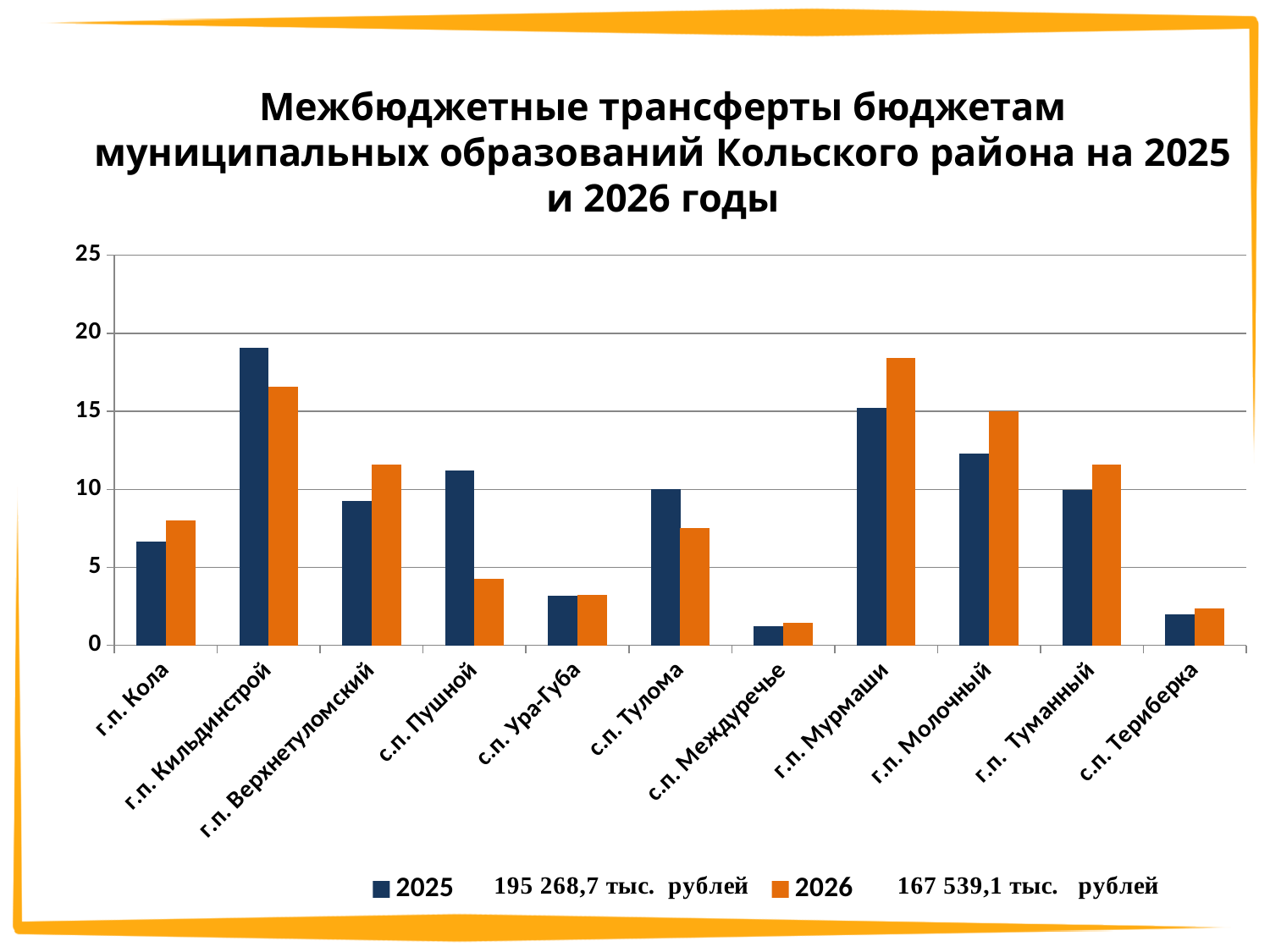
Is the 2025 value for г.п. Кильдинстрой greater or less than 15? greater What kind of chart is shown on the slide? bar chart What colour are the bars for the 2026 series? orange For г.п. Мурмаши, which is larger: the 2025 value or the 2026 value? 2026 How many series does the legend list? 2 Which two years are listed in the legend? 2025 and 2026 Which municipality has the highest value in the 2025 series? г.п. Кильдинстрой Which municipality has the highest value in the 2026 series? г.п. Мурмаши How many municipalities (categories) are shown along the x axis? 11 For с.п. Пушной, which is larger: the 2025 value or the 2026 value? 2025 Is the 2026 value for с.п. Пушной greater or less than 5? less Which municipality has the lowest value in the 2025 series? с.п. Междуречье